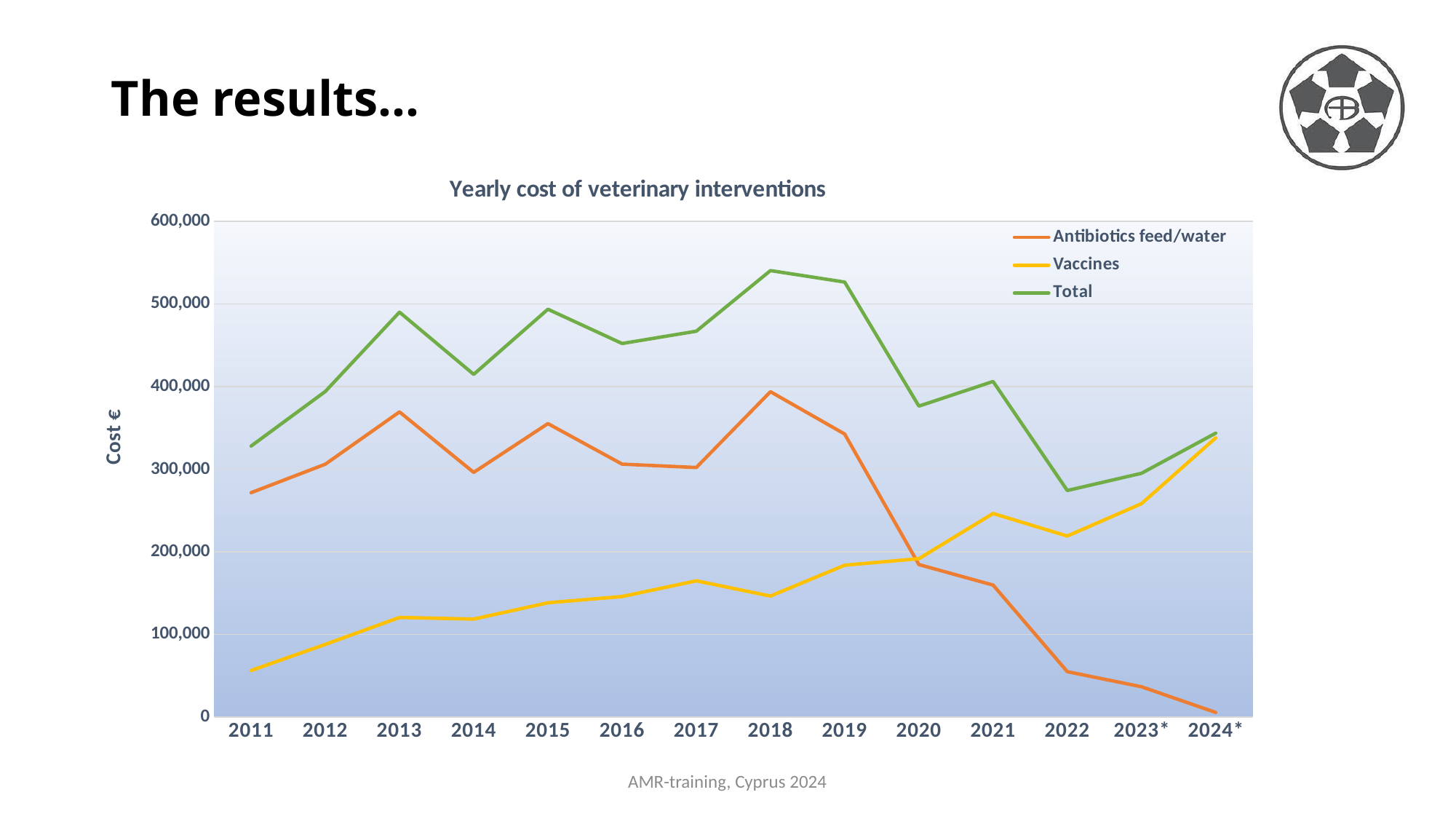
What kind of chart is shown on the slide? line chart Is the Antibiotics feed/water value for 2022 greater or less than 100,000? less In 2021, which is larger: the Antibiotics feed/water cost or the Vaccines cost? Vaccines Does the Antibiotics feed/water cost rise or fall from 2018 to 2024*? fall How many series does the legend list? 3 In which year is the Vaccines cost lowest? 2011 Is the Vaccines value for 2024* greater or less than 300,000? greater Is the Total value for 2018 greater or less than 500,000? greater In which year is the Total cost highest? 2018 In which year is the Antibiotics feed/water cost highest? 2018 In which year is the Total cost lowest? 2022 How many years are shown on the x axis? 14